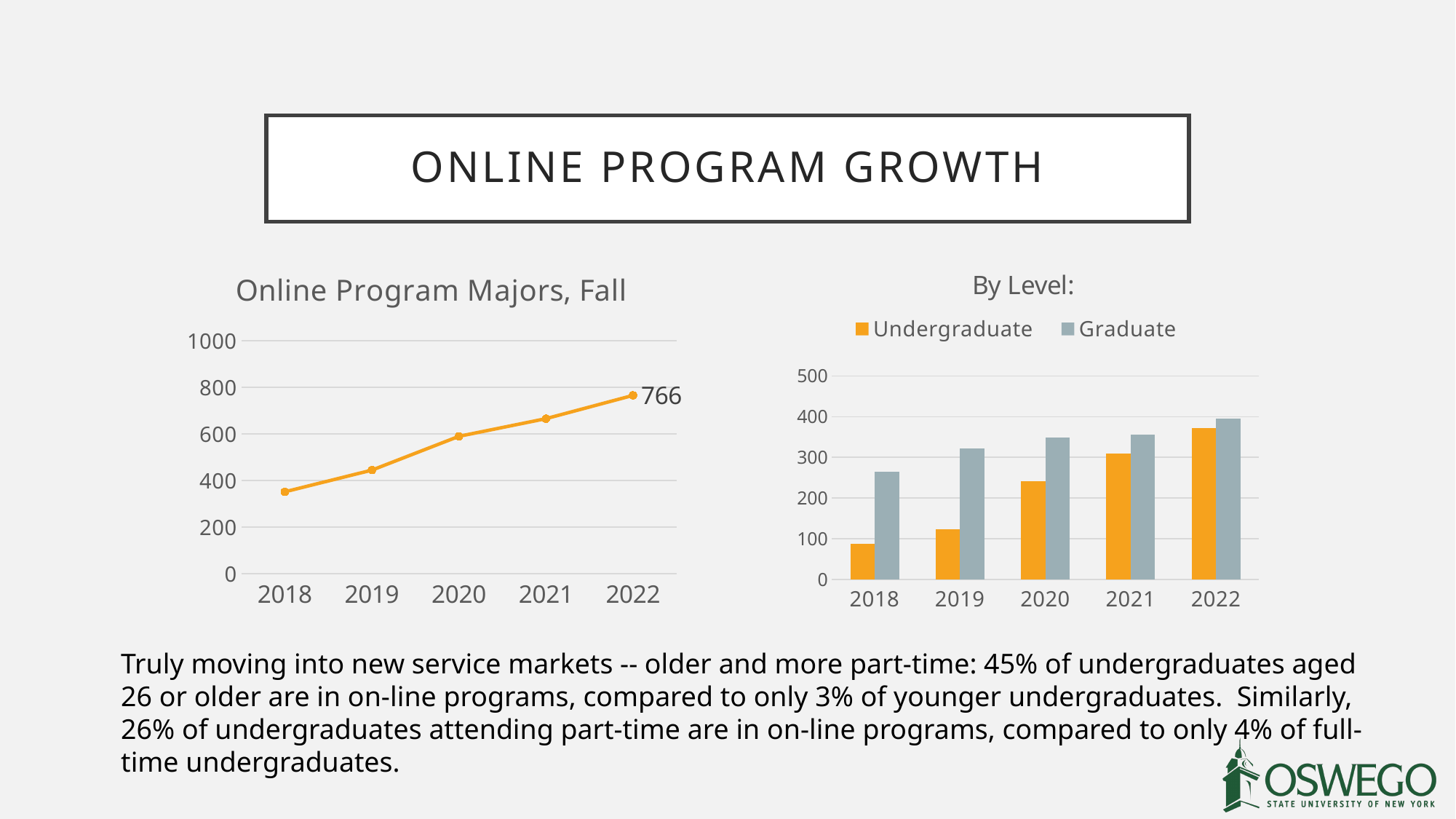
In the 'Online Program Majors, Fall' chart, is the value for 2018 greater or less than 400? less What kind of chart is the 'Online Program Majors, Fall' chart? line chart In the 'Online Program Majors, Fall' chart, do the values rise or fall from 2018 to 2022? rise How many years are plotted in the 'Online Program Majors, Fall' chart? 5 In the 'By Level:' chart, which is larger for 2018, Undergraduate or Graduate? Graduate In the 'Online Program Majors, Fall' chart, which year has the highest value? 2022 What kind of chart is the 'By Level:' chart? bar chart In the 'By Level:' chart, what colour represents the Undergraduate series? orange How many series does the legend of the 'By Level:' chart list? 2 In the 'By Level:' chart, which year has the lowest Undergraduate value? 2018 In the 'By Level:' chart, is the Undergraduate value for 2018 greater or less than 100? less In the 'Online Program Majors, Fall' chart, what is the value for 2022? 766